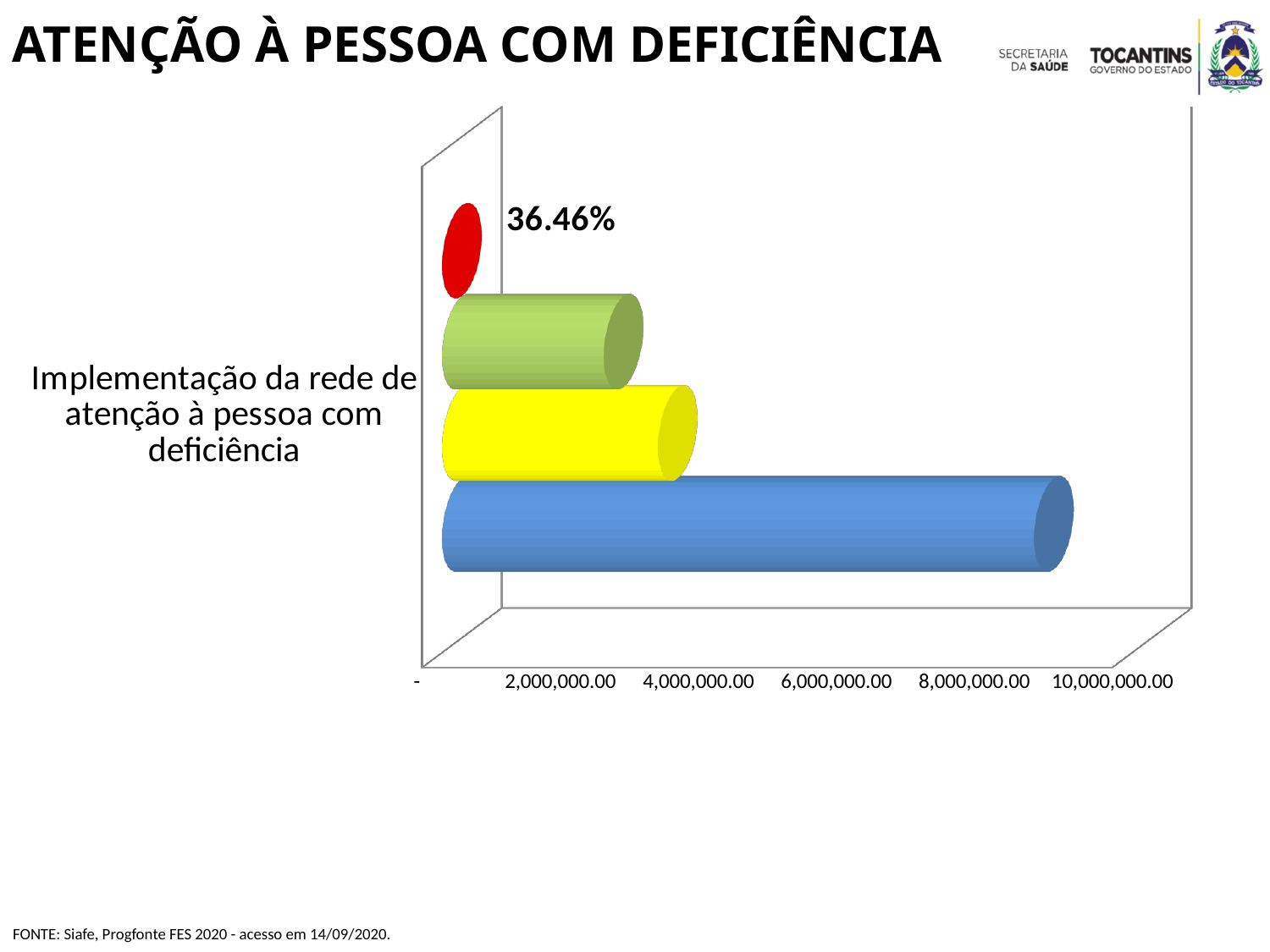
What value is printed as a data label next to the red bar? 36.46% How many bars are plotted in the chart? 4 Is the value of the yellow bar greater or less than 4,000,000.00? less Which is larger, the yellow bar or the green bar? yellow bar What is the category label shown on the chart? Implementação da rede de atenção à pessoa com deficiência Which coloured bar is the shortest in the chart? red Is the value of the blue bar greater or less than 8,000,000.00? greater How many categories are shown on the vertical axis of the chart? 1 Is the value of the green bar greater or less than 2,000,000.00? greater What is the highest tick value shown on the horizontal axis? 10,000,000.00 Which coloured bar is the longest in the chart? blue What kind of chart is shown on the slide? bar chart